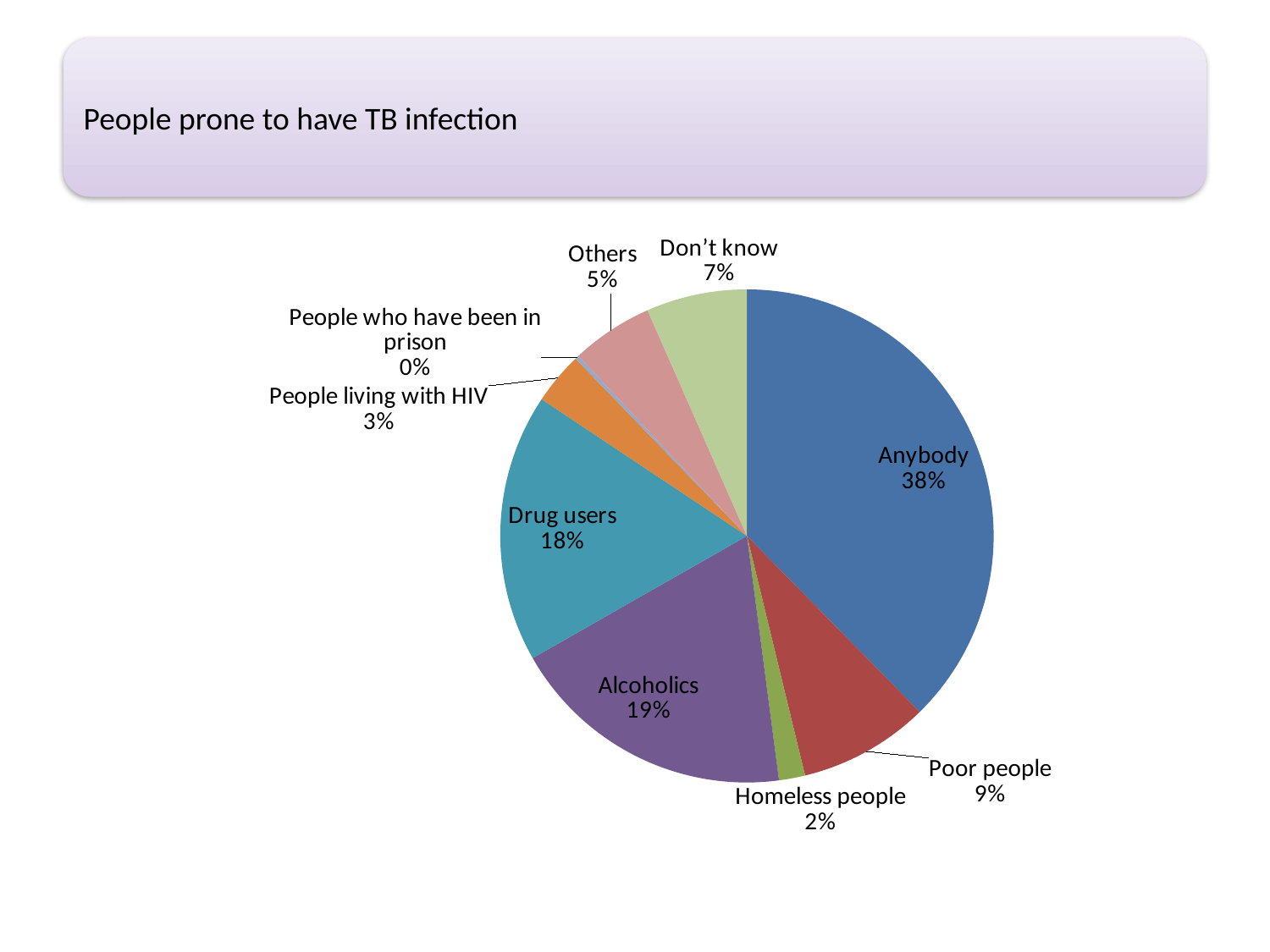
What kind of chart is shown on the slide? Pie chart What is the title of the slide containing the chart? People prone to have TB infection Which is larger, the value for Don't know or the value for Others? Don't know What share of the pie does Anybody account for? 38% What is the value for Drug users? 18% Which category has the largest slice of the pie? Anybody What is the difference between the values for Anybody and Alcoholics? 19% What is the value for Poor people? 9% What is the value for People living with HIV? 3% Which category has the smallest slice of the pie? People who have been in prison What is the value for Alcoholics? 19% How many categories are shown in the pie chart? 9